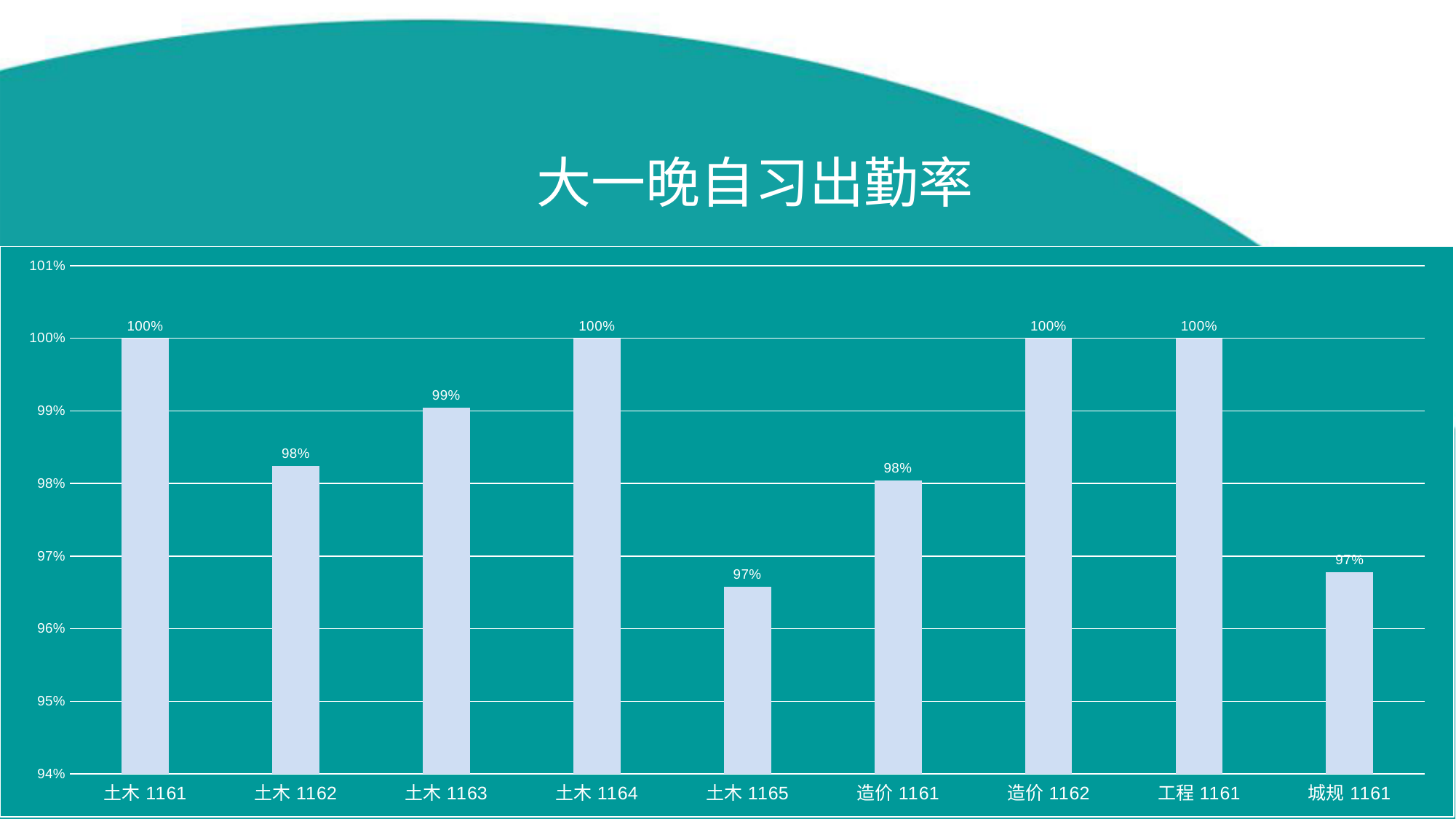
What is the title of the slide? 大一晚自习出勤率 What is the difference between the values for 土木 1163 and 土木 1162? 1% What is the value for 工程 1161? 100% What is the value for 土木 1163? 99% What kind of chart is shown on the slide? bar chart What is the difference between the values for 土木 1161 and 土木 1165? 3% Which is larger, the value for 造价 1162 or the value for 造价 1161? 造价 1162 How many categories are shown on the x axis? 9 Which is larger, the value for 土木 1163 or the value for 土木 1162? 土木 1163 What is the value for 城规 1161? 97% What is the value for 造价 1161? 98%